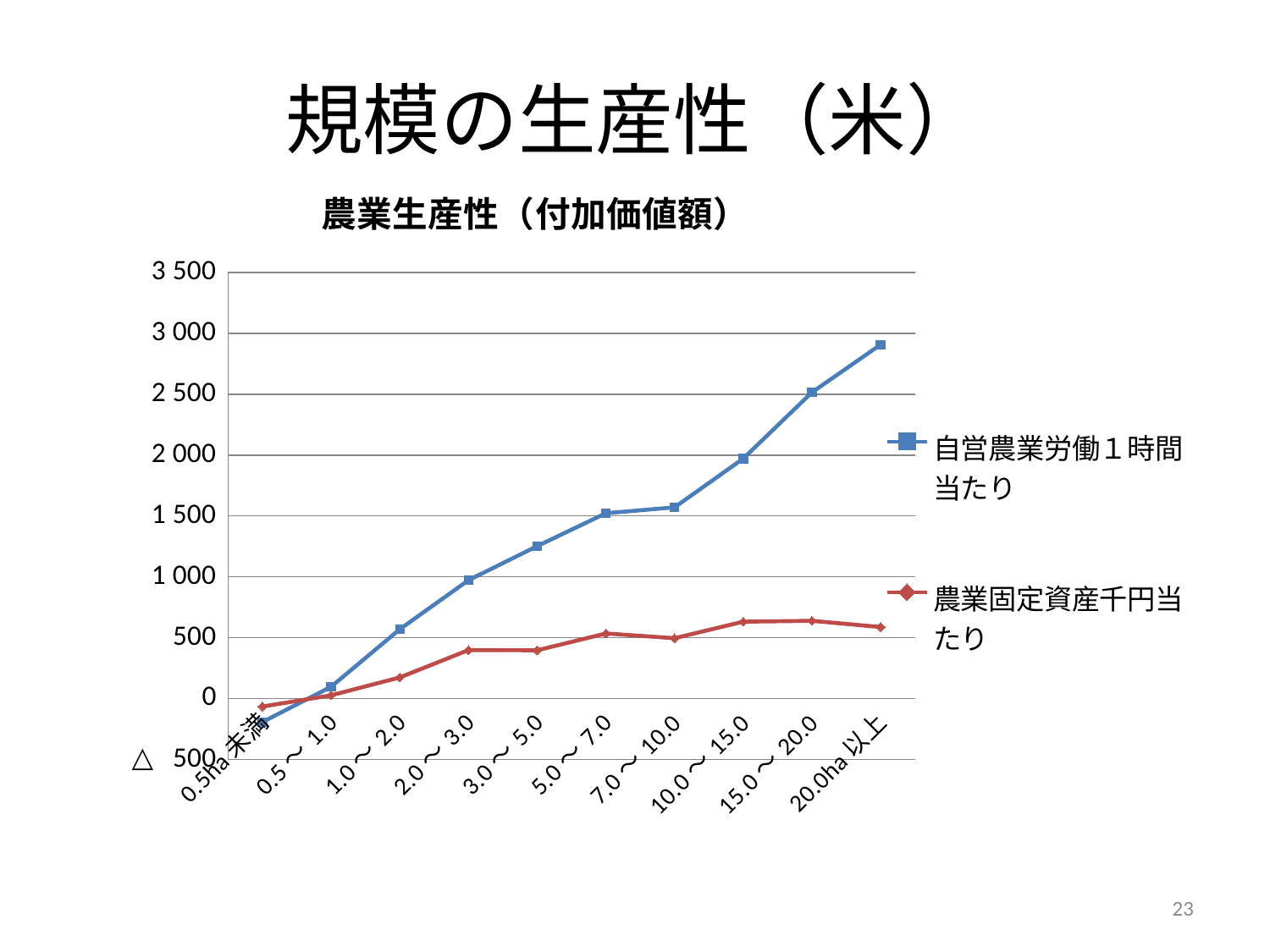
How many series does the legend list? 2 At 20.0ha以上, which series has the larger value, 自営農業労働１時間当たり or 農業固定資産千円当たり? 自営農業労働１時間当たり Is the value of 自営農業労働１時間当たり for 20.0ha以上 greater or less than 2 500? greater Which series is drawn in blue with square markers? 自営農業労働１時間当たり For the 自営農業労働１時間当たり series, which category has the lowest value? 0.5ha未満 For the 自営農業労働１時間当たり series, which category has the highest value? 20.0ha以上 How many farm-size categories are plotted along the x axis? 10 Is the value of 自営農業労働１時間当たり for 0.5ha未満 greater or less than 0? less Does the 自営農業労働１時間当たり series generally rise or fall as farm size increases along the x axis? rise Is the value of 農業固定資産千円当たり for 2.0～3.0 greater or less than 500? less What is the title of the chart? 農業生産性（付加価値額） What kind of chart is shown on the slide? line chart